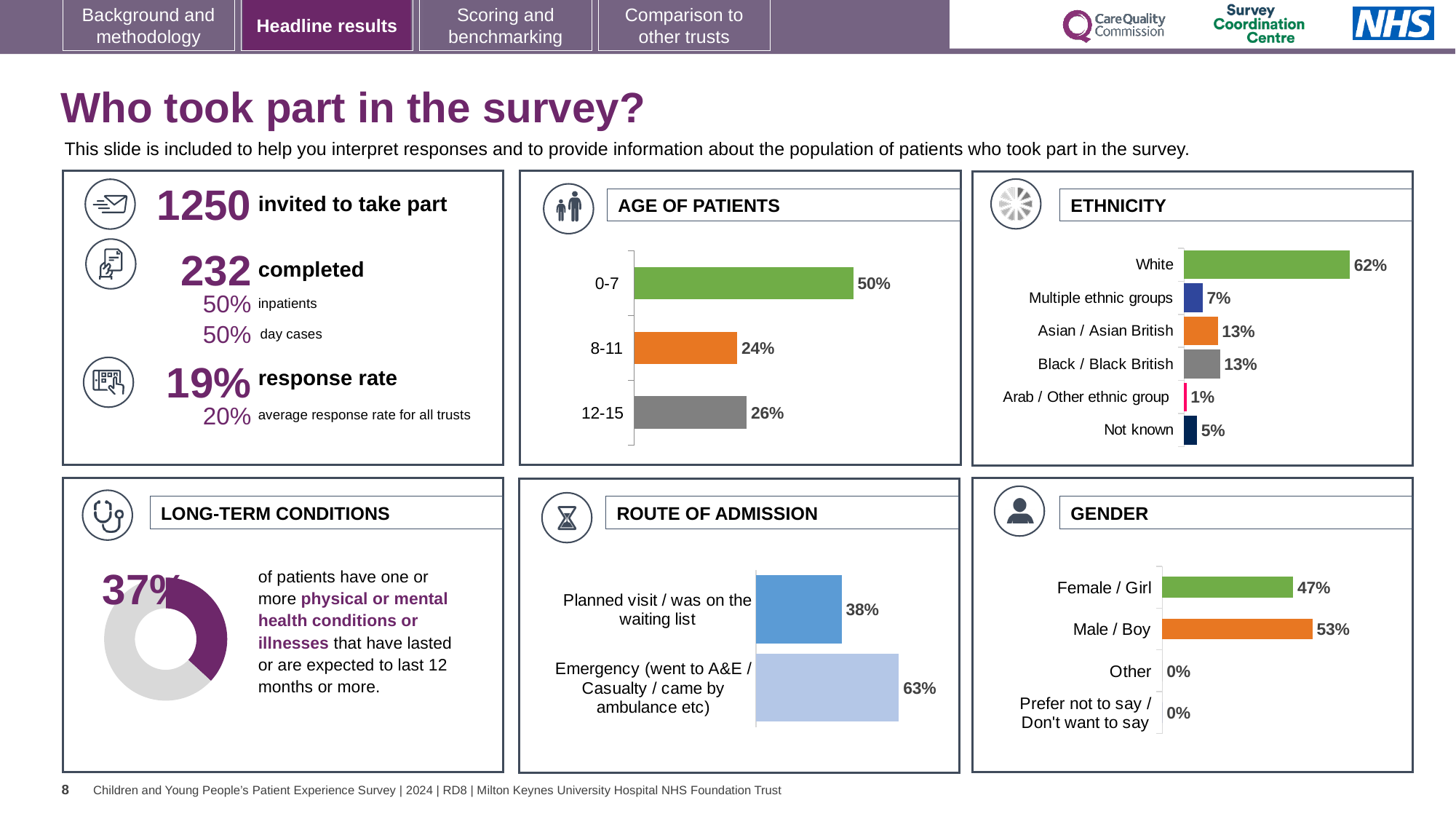
What kind of chart is used in the LONG-TERM CONDITIONS panel? Donut (pie) chart How many categories are shown in the ETHNICITY chart? 6 In the ETHNICITY chart, what is the difference between the White and Not known percentages? 57% In the ETHNICITY chart, which category has the lowest percentage? Arab / Other ethnic group In the ROUTE OF ADMISSION chart, which route has the larger percentage: Planned visit / was on the waiting list or Emergency? Emergency (went to A&E / Casualty / came by ambulance etc) In the GENDER chart, what percentage of patients are Male / Boy? 53% In the AGE OF PATIENTS chart, which age group has the lowest percentage? 8-11 In the ETHNICITY chart, what percentage of patients are White? 62% In the AGE OF PATIENTS chart, what percentage of patients are aged 0-7? 50% In the AGE OF PATIENTS chart, what is the difference between the 12-15 and 8-11 percentages? 2% In the ROUTE OF ADMISSION chart, what percentage of patients came via Emergency (went to A&E / Casualty / came by ambulance etc)? 63% In the GENDER chart, what is the difference between the Male / Boy and Female / Girl percentages? 6%